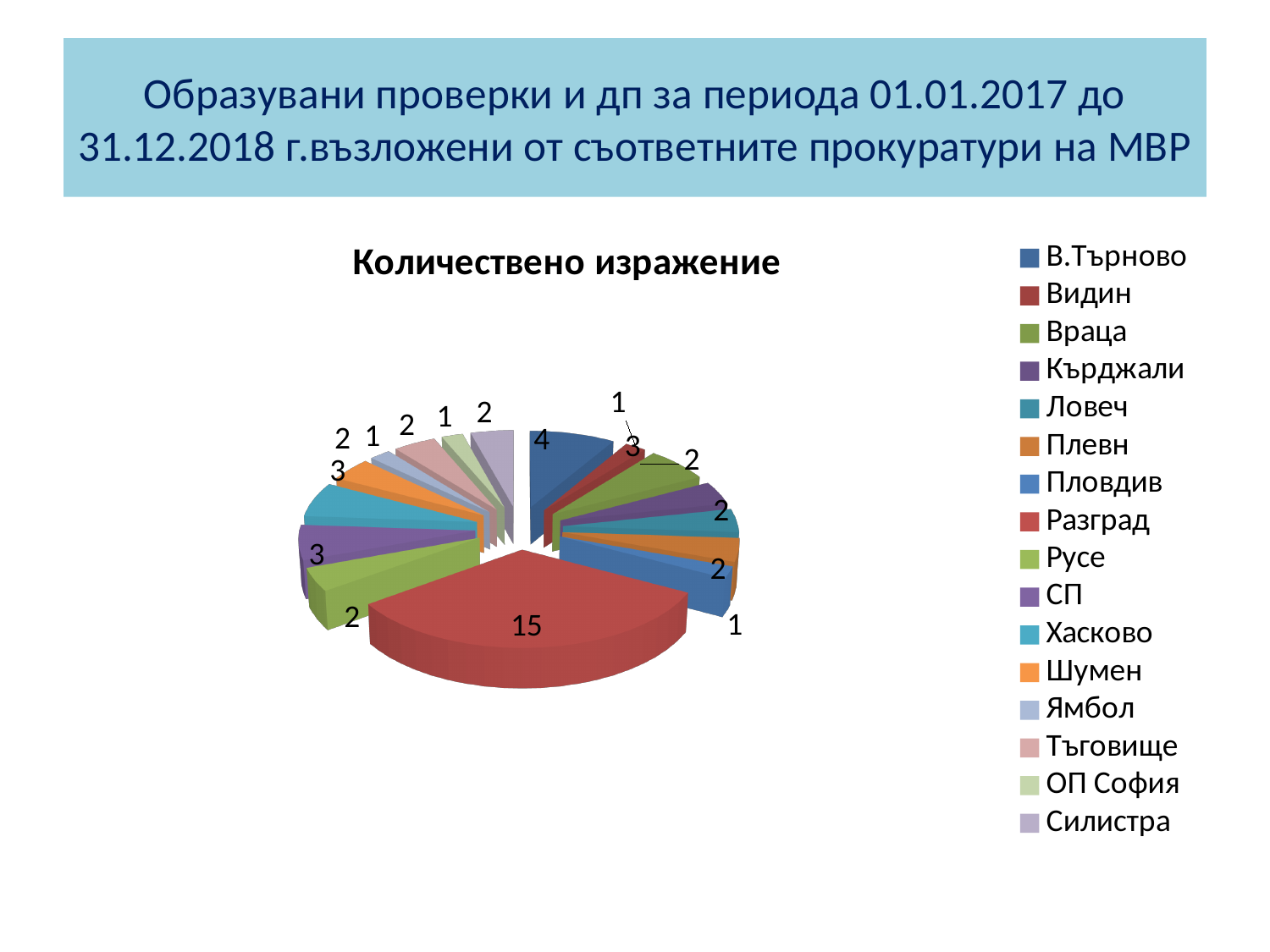
How many categories does the legend of the pie chart list? 16 What kind of chart is shown on the slide? pie chart What is the value shown for Русе? 2 What is the value shown for В.Търново? 4 What is the value shown for Разград? 15 Which category has the largest slice in the pie chart? Разград Which is larger, the value for Разград or the value for В.Търново? Разград What is the difference between the values for Разград and В.Търново? 11 What is the value shown for СП? 3 What is the title of the chart? Количествено изражение Which legend entry is listed last in the chart's legend? Силистра What is the value shown for Хасково? 3